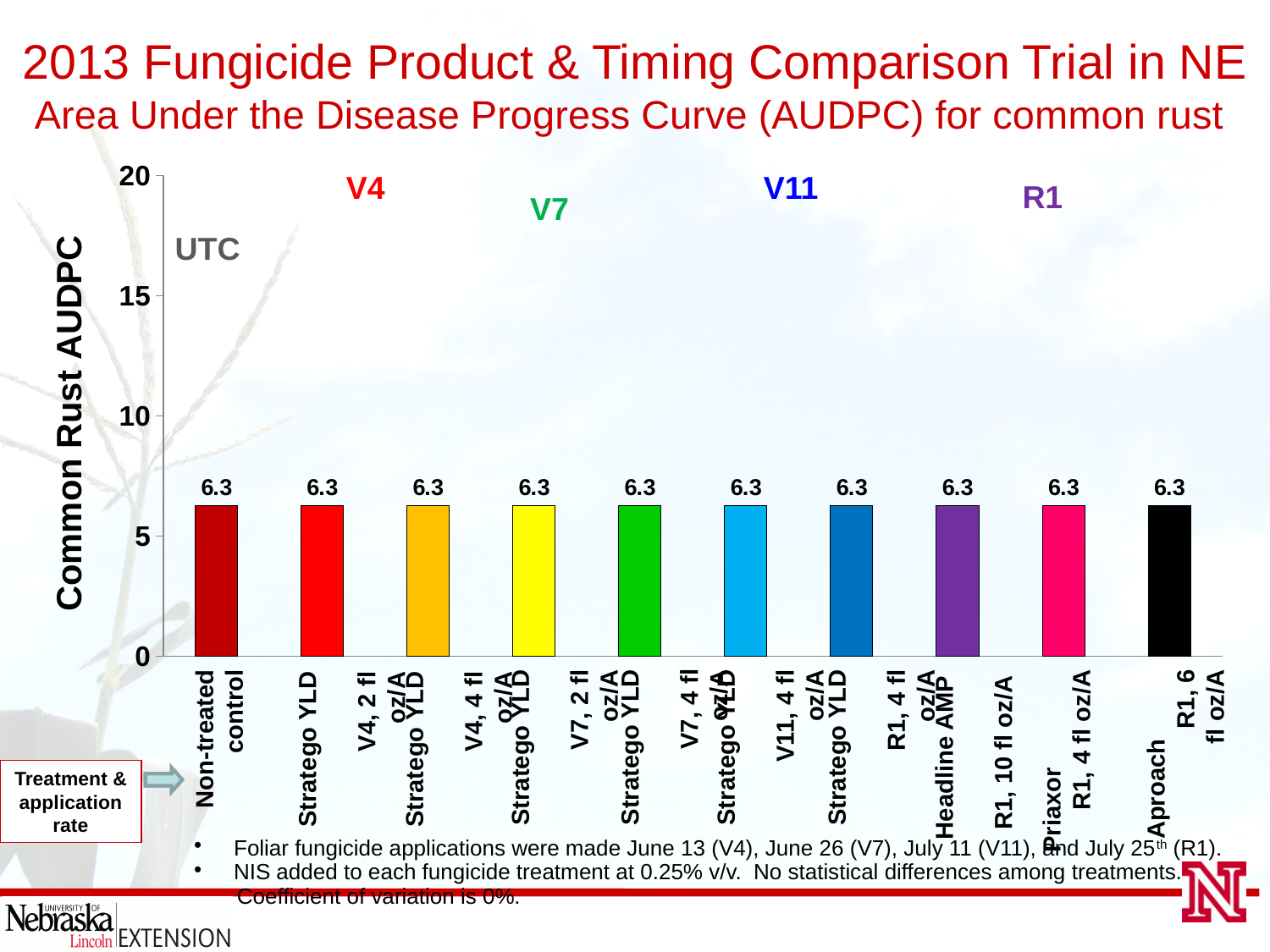
Is the Common Rust AUDPC value for the Non-treated control greater or less than 10? less Is the Common Rust AUDPC value for Headline AMP at R1, 10 fl oz/A greater or less than 5? greater What is the Common Rust AUDPC value for Priaxor at R1, 4 fl oz/A? 6.3 What kind of chart is shown on the slide? bar chart What is the maximum value shown on the y axis of the chart? 20 What is the difference in Common Rust AUDPC between the Non-treated control and Stratego YLD at V4, 2 fl oz/A? 0 What is the Common Rust AUDPC value for Aproach at R1, 6 fl oz/A? 6.3 Do the Common Rust AUDPC values rise, fall, or stay the same across the treatments along the x axis? stay the same How many treatment bars are shown in the chart? 10 What is the Common Rust AUDPC value for Headline AMP at R1, 10 fl oz/A? 6.3 What is the label of the y axis of the chart? Common Rust AUDPC What is the Common Rust AUDPC value for the Non-treated control? 6.3